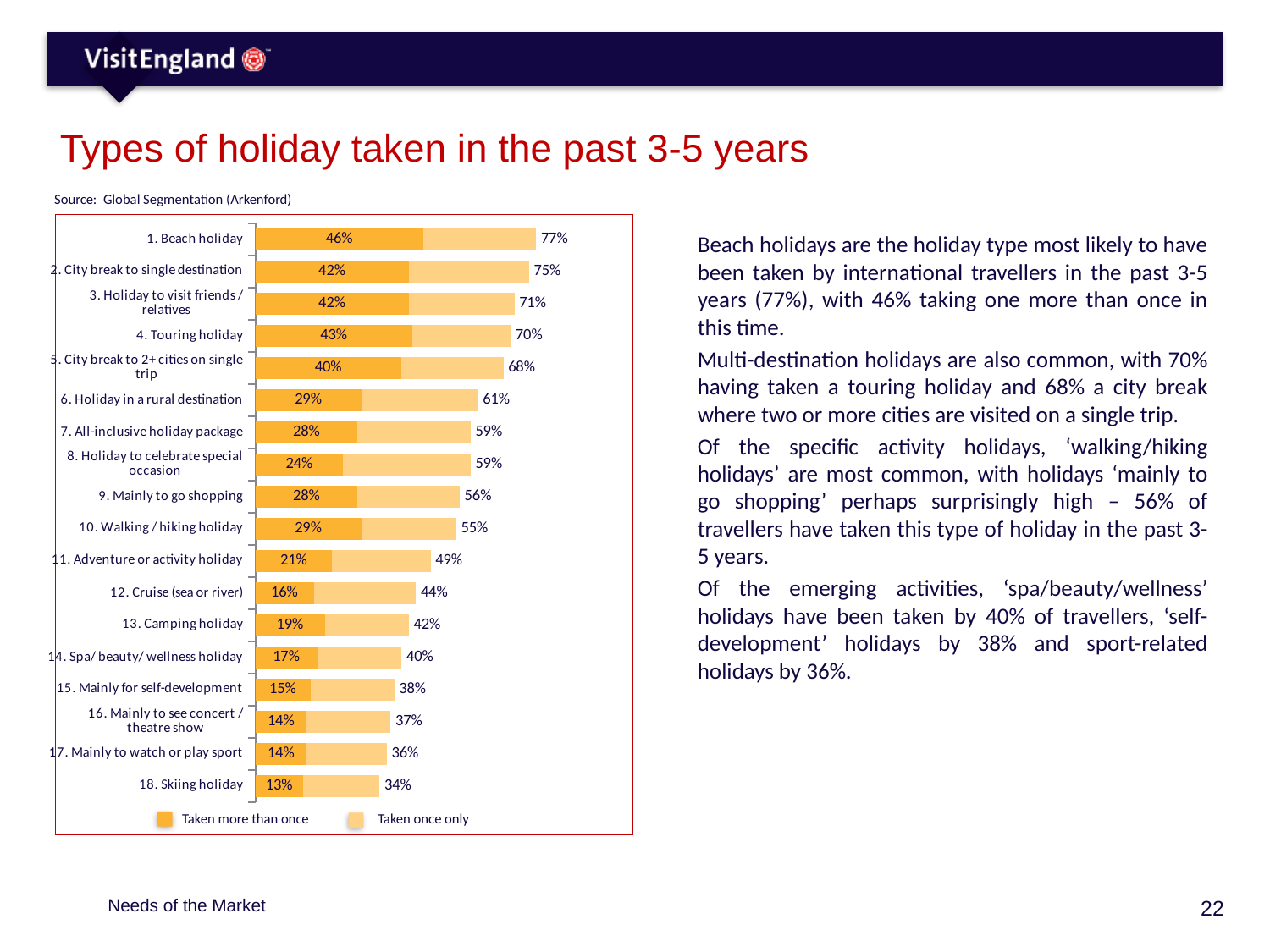
What are the two legend entries in the chart? Taken more than once; Taken once only What is the difference between the total percentage for '2. City break to single destination' (75%) and '18. Skiing holiday' (34%)? 41% What kind of chart is shown on the slide? Stacked bar chart Which holiday type has the highest total percentage? 1. Beach holiday What percentage of travellers have taken a beach holiday more than once? 46% What is the total percentage shown for '4. Touring holiday'? 70% Which has a higher total percentage: '9. Mainly to go shopping' or '10. Walking / hiking holiday'? 9. Mainly to go shopping How many holiday types are listed in the chart? 18 What percentage is shown for 'Taken more than once' for '12. Cruise (sea or river)'? 16% What is the difference between the total percentage for beach holiday (77%) and the 'taken more than once' percentage for beach holiday (46%)? 31% How many series does the legend list? 2 Which holiday type has the lowest total percentage? 18. Skiing holiday